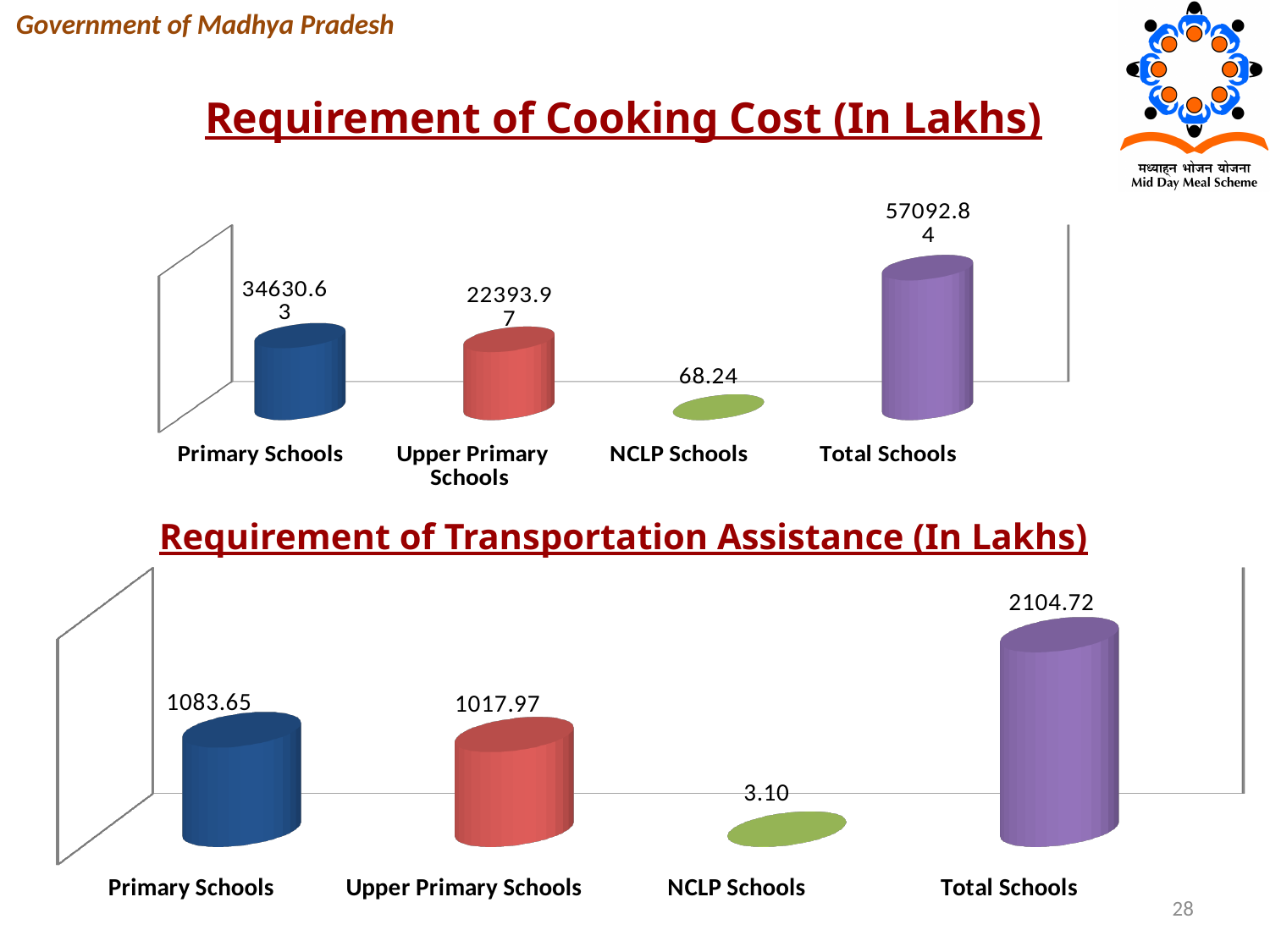
In the Requirement of Transportation Assistance chart, which is larger, Primary Schools or Upper Primary Schools? Primary Schools In the Requirement of Cooking Cost chart, what is the difference between Primary Schools and Upper Primary Schools? 12236.66 In the Requirement of Transportation Assistance chart, what is the value for Upper Primary Schools? 1017.97 In the Requirement of Cooking Cost chart, which category has the highest value? Total Schools In the Requirement of Transportation Assistance chart, what is the value for Total Schools? 2104.72 In the Requirement of Cooking Cost chart, what is the value for NCLP Schools? 68.24 In the Requirement of Transportation Assistance chart, which category has the lowest value? NCLP Schools In the Requirement of Cooking Cost chart, which category has the lowest value? NCLP Schools What kind of chart is the Requirement of Transportation Assistance chart? Bar chart In the Requirement of Cooking Cost chart, how many categories are shown? 4 In the Requirement of Transportation Assistance chart, what is the difference between Primary Schools and Upper Primary Schools? 65.68 In the Requirement of Cooking Cost chart, what is the value for Primary Schools? 34630.63